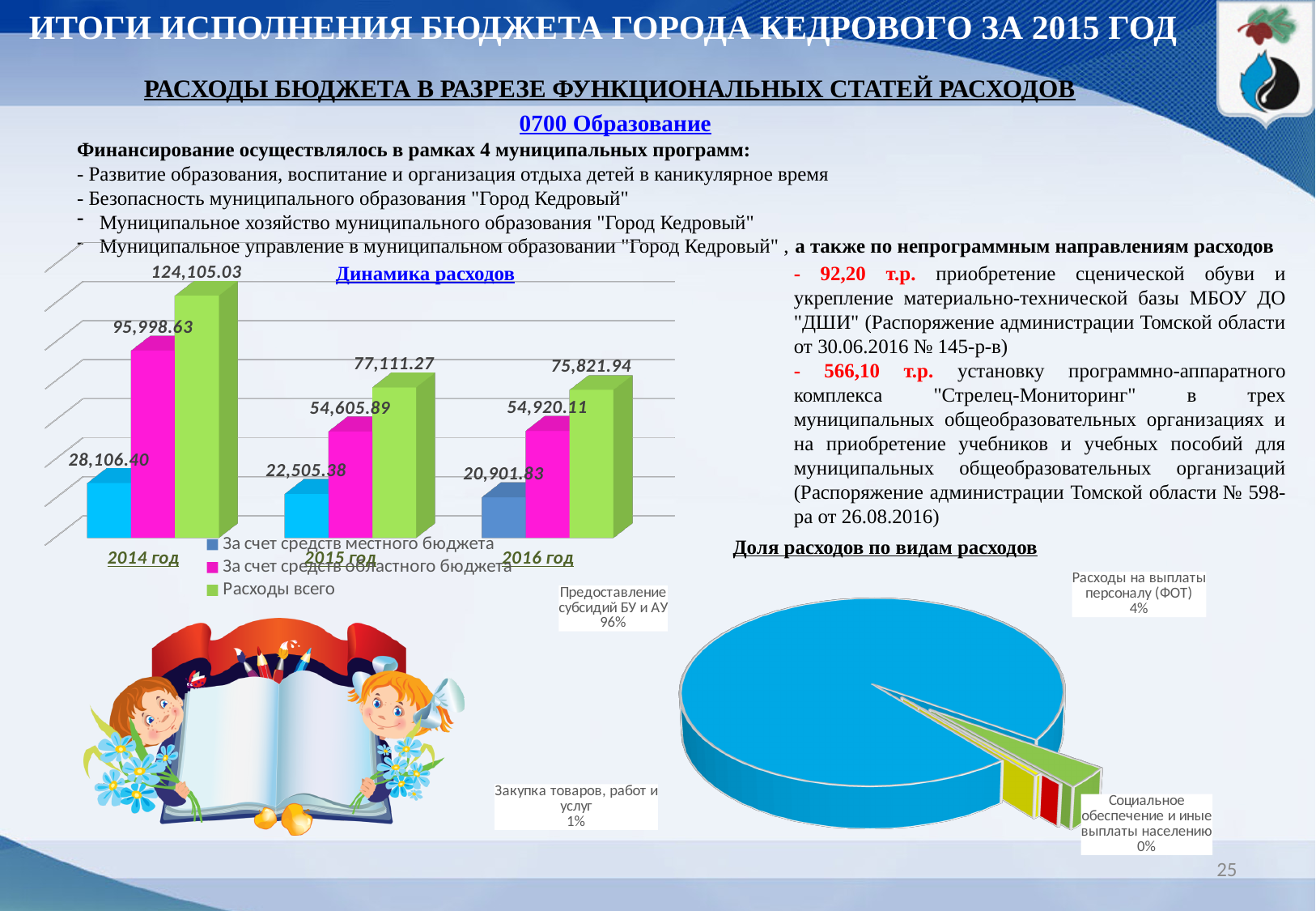
What kind of chart is 'Динамика расходов'? bar chart On the 'Динамика расходов' chart, how many series does the legend list? 3 On the 'Доля расходов по видам расходов' pie chart, what share does 'Предоставление субсидий БУ и АУ' have? 96% On the 'Динамика расходов' chart, which is larger: 'За счет средств областного бюджета' for 2014 год or for 2016 год? 2014 год On the 'Динамика расходов' chart, what is the value of 'За счет средств местного бюджета' for 2016 год? 20,901.83 On the 'Динамика расходов' chart, which year has the highest value for 'Расходы всего'? 2014 год On the 'Доля расходов по видам расходов' pie chart, what share does 'Расходы на выплаты персоналу (ФОТ)' have? 4% On the 'Динамика расходов' chart, what is the difference between 'Расходы всего' for 2015 год and 2016 год? 1,289.33 On the 'Динамика расходов' chart, which year has the lowest value for 'За счет средств местного бюджета'? 2016 год On the 'Динамика расходов' chart, what is the value of 'За счет средств областного бюджета' for 2015 год? 54,605.89 On the 'Динамика расходов' chart, what is the value of 'Расходы всего' for 2014 год? 124,105.03 On the 'Динамика расходов' chart, does 'Расходы всего' rise or fall from 2014 год to 2016 год? fall